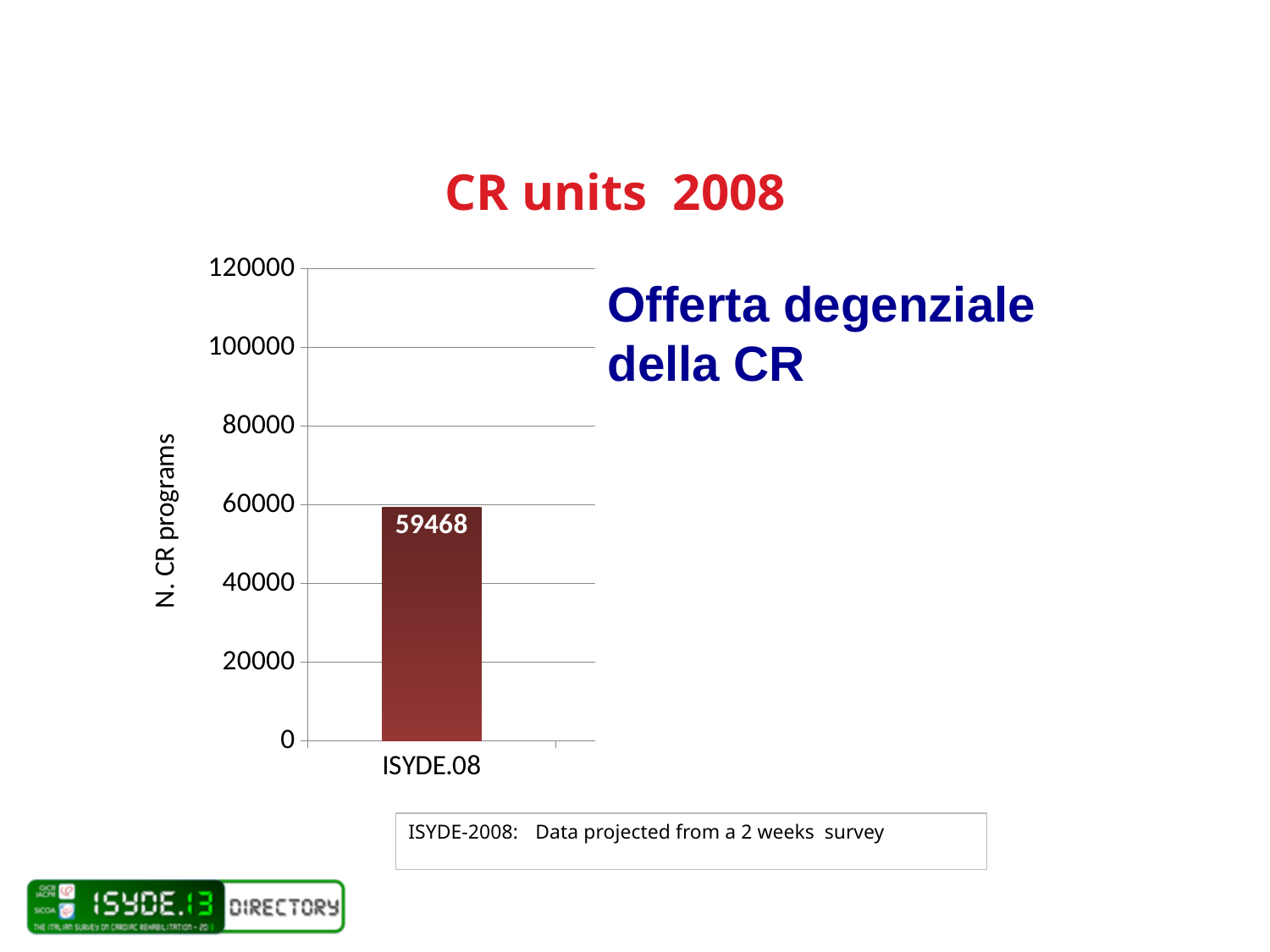
What is the maximum value shown on the vertical axis? 120000 Is the value for ISYDE.08 greater or less than 60000? less What is the category label on the horizontal axis? ISYDE.08 What is the label of the vertical axis? N. CR programs What kind of chart is shown on the slide? bar chart What is the value for ISYDE.08? 59468 What is the title of the chart? CR units 2008 Is the value for ISYDE.08 greater or less than 40000? greater How many bars are plotted in the chart? 1